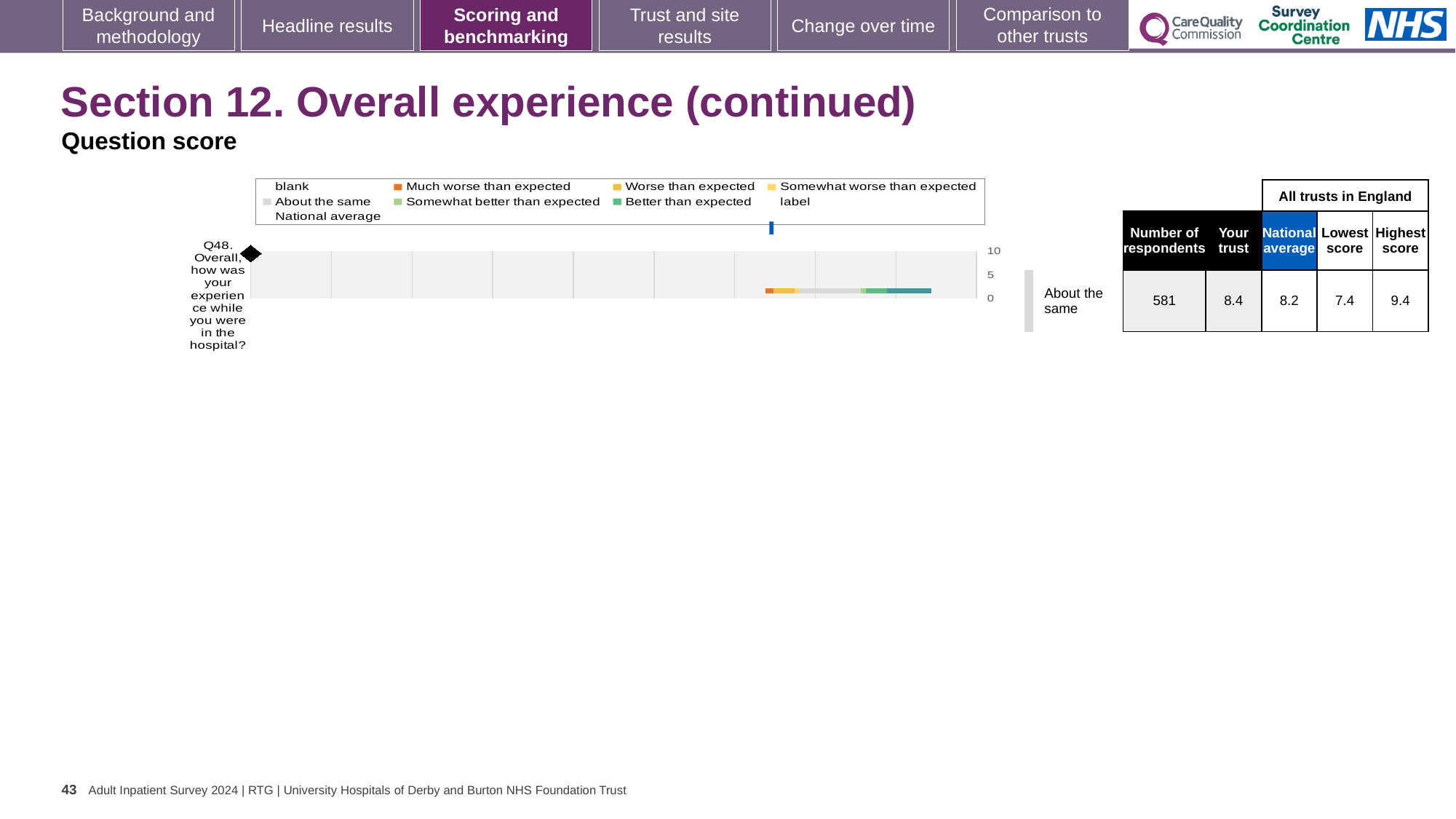
What is the Highest score among all trusts in England for Q48? 9.4 Which survey question is plotted in the chart? Q48. Overall, how was your experience while you were in the hospital? How many respondents answered Q48? 581 What is the 'Your trust' score for Q48? 8.4 What is the difference between the 'Your trust' score and the National average for Q48? 0.2 What is the difference between the Highest score and the Lowest score for Q48? 2.0 What kind of chart is shown on the slide? bar chart What is the National average score for Q48? 8.2 Which is larger for Q48, the 'Your trust' score or the National average? Your trust What benchmark category is shown next to the chart for Q48? About the same How many survey questions are plotted in the chart? 1 What is the Lowest score among all trusts in England for Q48? 7.4